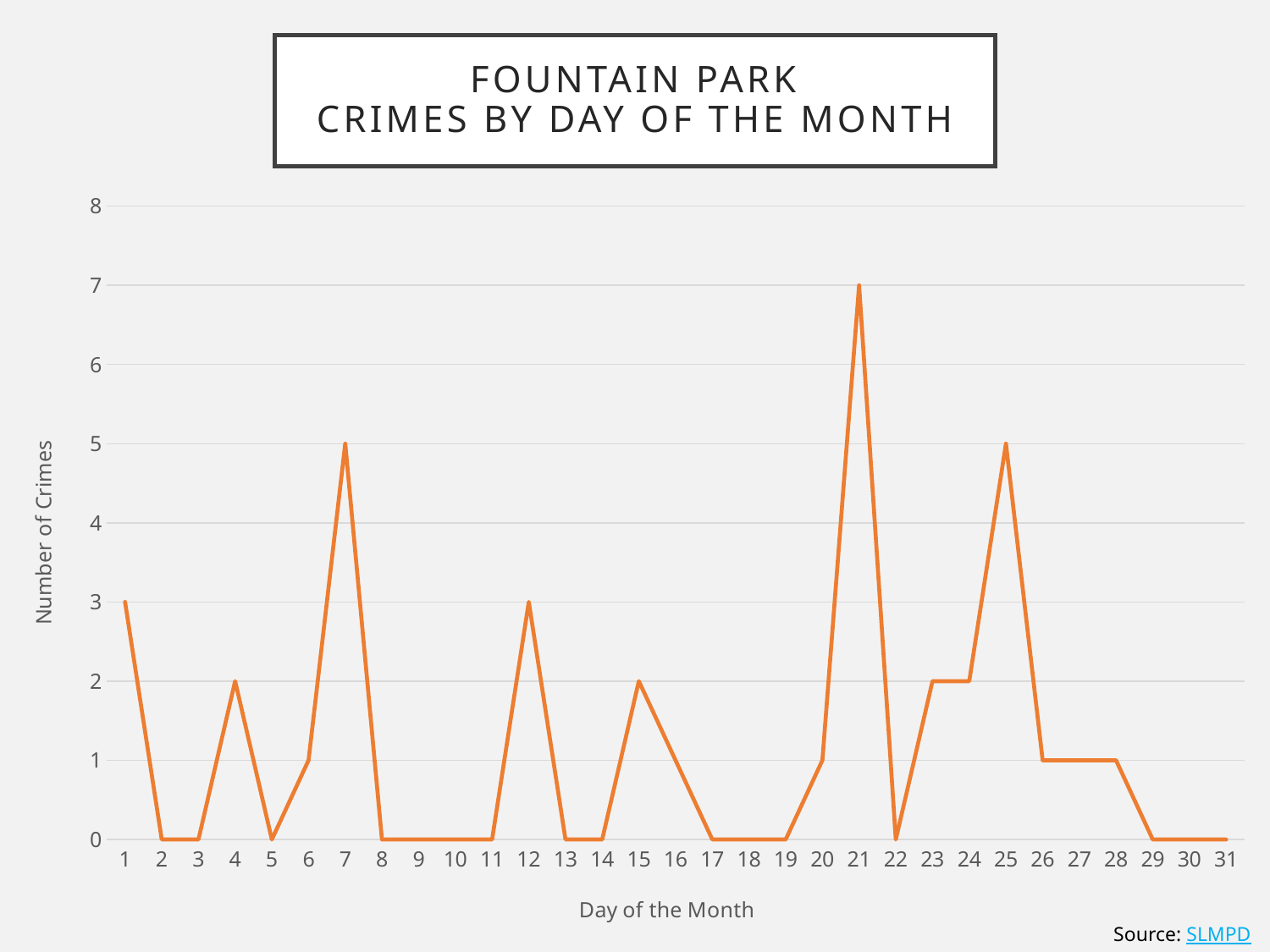
How many crimes were recorded on day 21? 7 What is the difference in the number of crimes between day 21 and day 25? 2 What type of chart is shown on the slide? Line chart Do the values rise or fall from day 21 to day 22? fall Which day had more crimes, day 12 or day 15? 12 How many days of the month are plotted on the x axis? 31 What is the title of the chart? Fountain Park Crimes by Day of the Month How many crimes were recorded on day 7? 5 Which day of the month had the highest number of crimes? 21 What is the label of the y axis? Number of Crimes Is the number of crimes on day 21 greater or less than 6? greater How many crimes were recorded on day 1? 3